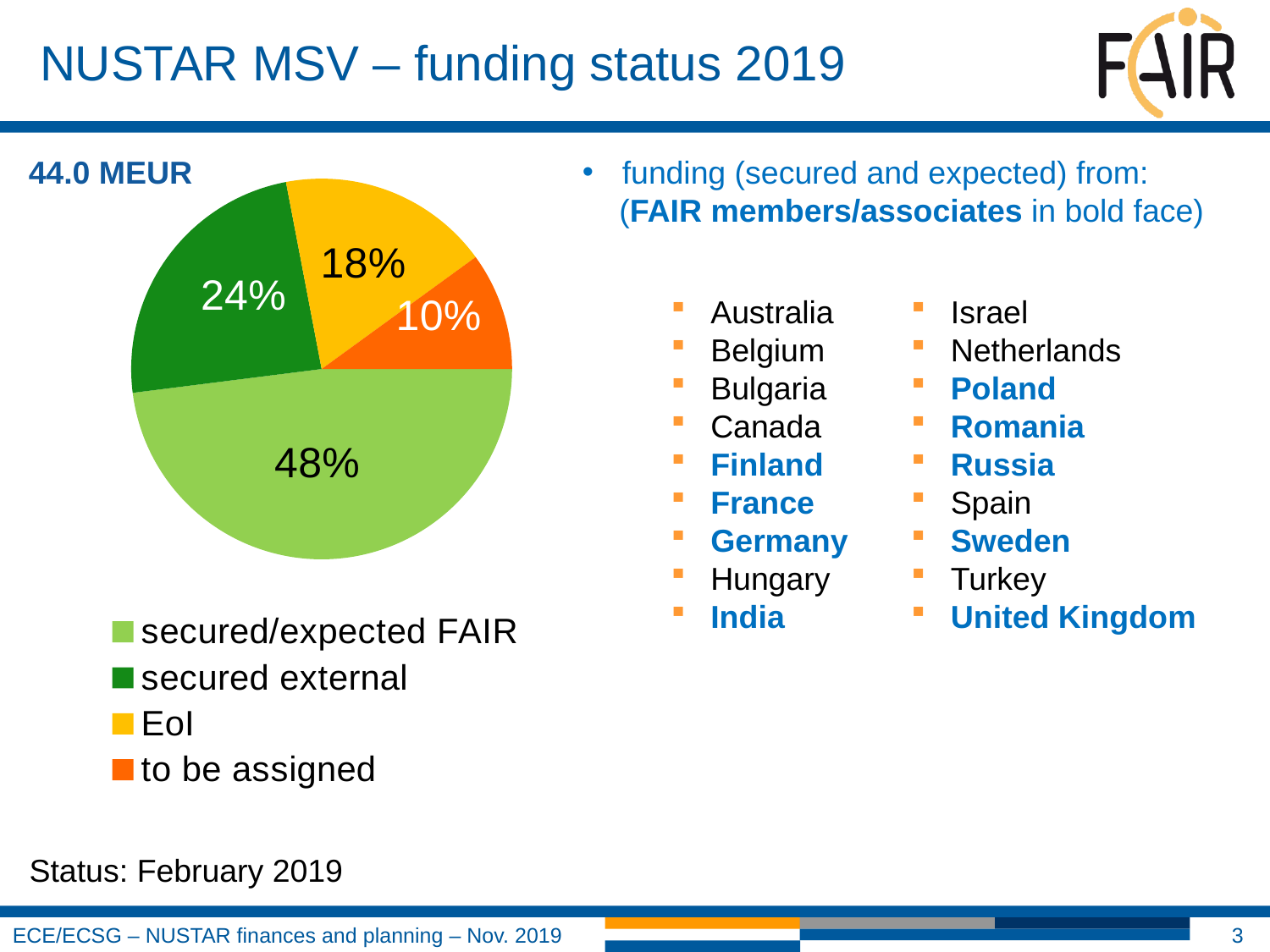
What share of the pie is labelled 'secured/expected FAIR'? 48% What is the difference in percentage points between the 'secured/expected FAIR' slice and the 'secured external' slice? 24 What share of the pie is labelled 'EoI'? 18% Which category has the largest slice of the pie? secured/expected FAIR What kind of chart is shown on the slide? pie chart How many slices does the pie chart have? 4 What colour is the 'to be assigned' slice in the pie chart? orange What share of the pie is labelled 'secured external'? 24% Which category has the smallest slice of the pie? to be assigned Which is larger, the 'EoI' slice or the 'to be assigned' slice? EoI What total amount is shown above the pie chart? 44.0 MEUR